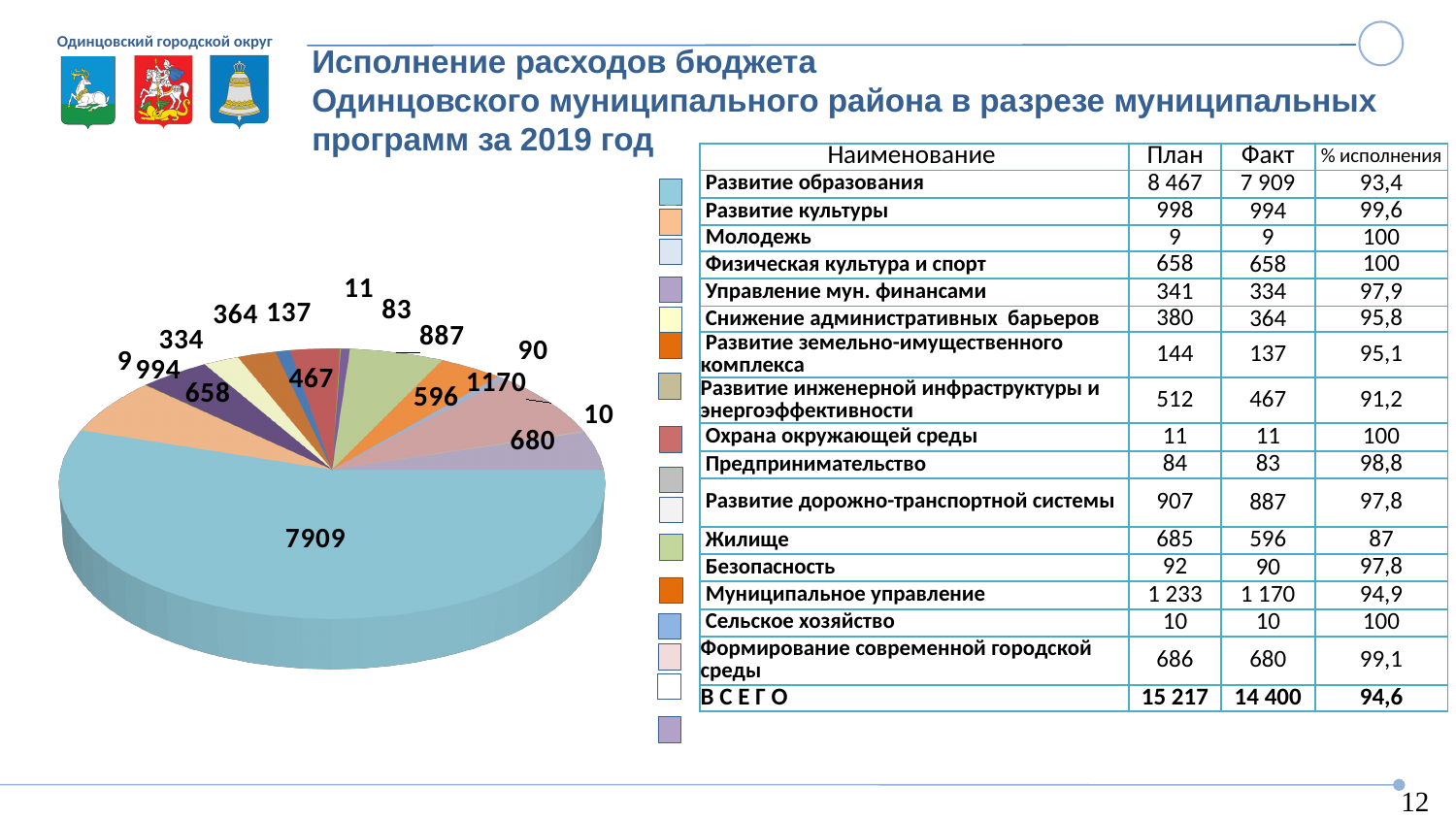
What is the difference between the slices labelled 1170 and 887 in the pie chart? 283 According to the legend colours, which programme does the largest light-blue slice (7909) represent? Развитие образования What is the value of the largest slice in the pie chart? 7909 How many slices in the pie chart have a value below 100? 5 What kind of chart is shown on the left of the slide? pie chart What year does the slide title say the budget expenditure data refers to? 2019 What is the difference between the largest slice (7909) and the slice labelled 1170 in the pie chart? 6739 How many slices does the pie chart have? 16 What is the value of the smallest labelled slice in the pie chart? 9 What is the difference between the slices labelled 364 and 334 in the pie chart? 30 In the pie chart, which slice is larger: the one labelled 680 or the one labelled 596? 680 In the pie chart, which slice is larger: the one labelled 994 or the one labelled 658? 994